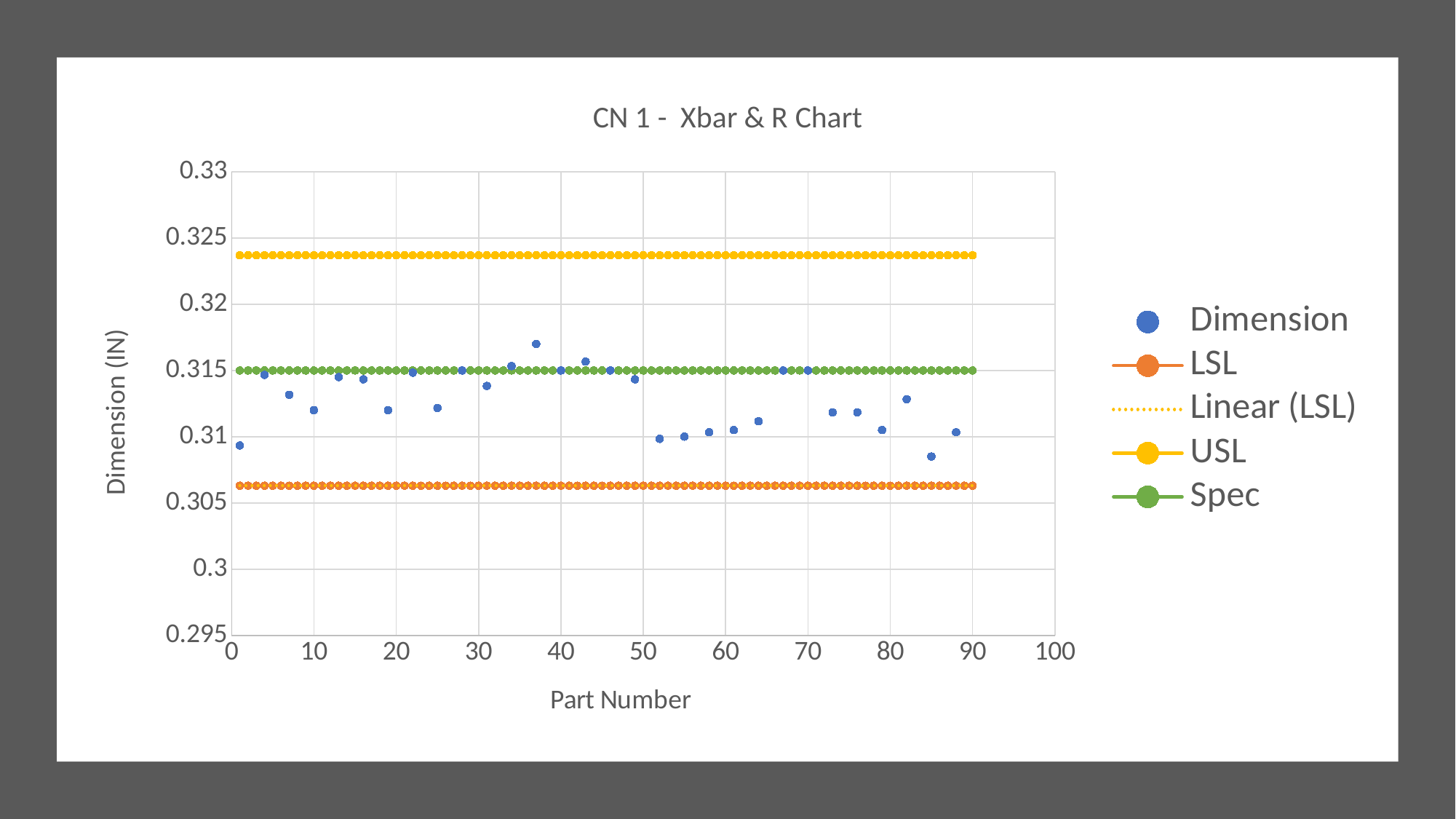
Which is larger, the USL series or the LSL series? USL At which part number is the Dimension value highest? 37 What kind of chart is shown on the slide? scatter chart How many series does the legend list? 5 What is the label of the vertical axis? Dimension (IN) Is the USL series greater or less than 0.32? greater Is the Dimension value at part number 85 greater or less than 0.31? less Is the LSL series greater or less than 0.305? greater What value does the Spec series sit at? 0.315 At which part number is the Dimension value lowest? 85 What is the title of the chart? CN 1 - Xbar & R Chart